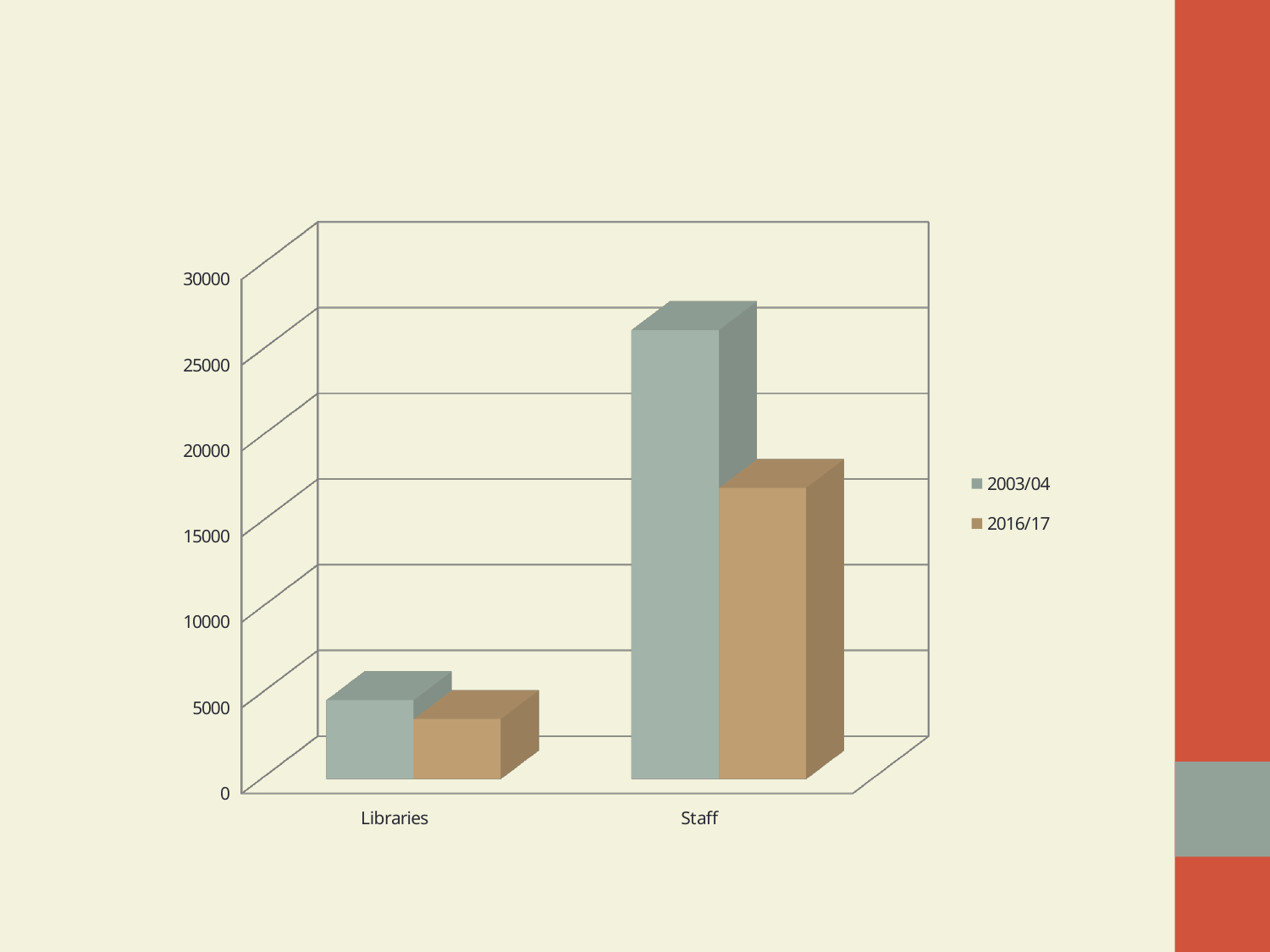
Is the value for Libraries in 2003/04 greater or less than 10000? less Which category has the tallest bar in the chart? Staff How many series does the chart's legend list? 2 Did the values for both categories rise or fall from 2003/04 to 2016/17? fall Which bar is the lowest in the chart? Libraries, 2016/17 For Libraries, which series has the larger value, 2003/04 or 2016/17? 2003/04 Is the value for Staff in 2003/04 greater or less than 20000? greater How many categories are shown on the x axis of the chart? 2 Is the value for Staff in 2016/17 greater or less than 10000? greater What kind of chart is shown on the slide? bar chart Which series are listed in the chart's legend? 2003/04 and 2016/17 For Staff, which series has the larger value, 2003/04 or 2016/17? 2003/04